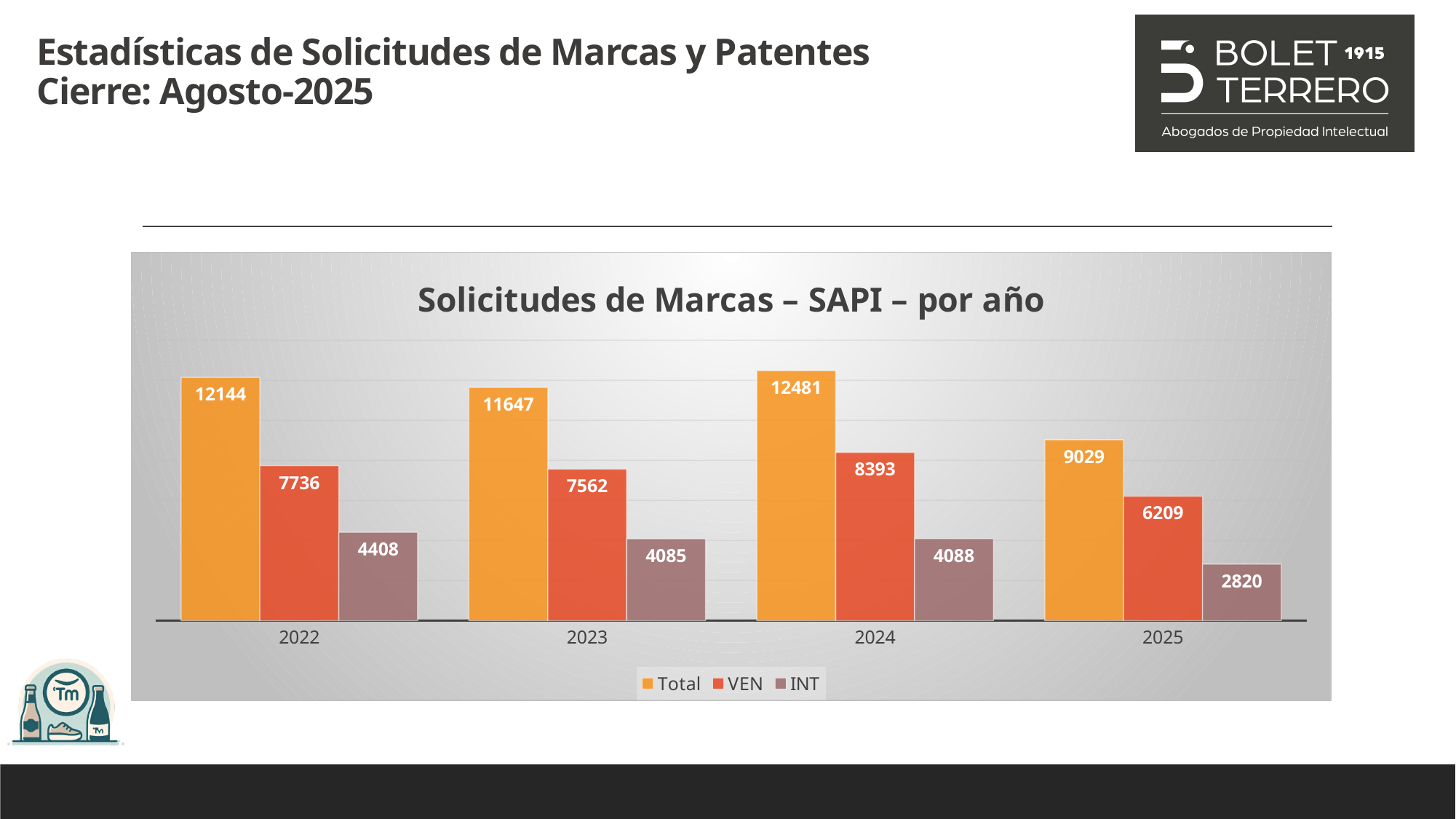
Which year has the highest Total value? 2024 Which year has the lowest INT value? 2025 What is the title of the chart? Solicitudes de Marcas – SAPI – por año What is the difference between the VEN values for 2024 and 2025? 2184 Which is larger, the Total value for 2022 or the Total value for 2023? 2022 What is the INT value for 2025? 2820 How many series does the legend list? 3 What kind of chart is shown on the slide? Bar chart What is the VEN value for 2022? 7736 How many years are shown on the x axis? 4 Does the VEN value rise or fall from 2024 to 2025? Fall What is the Total value for 2024? 12481